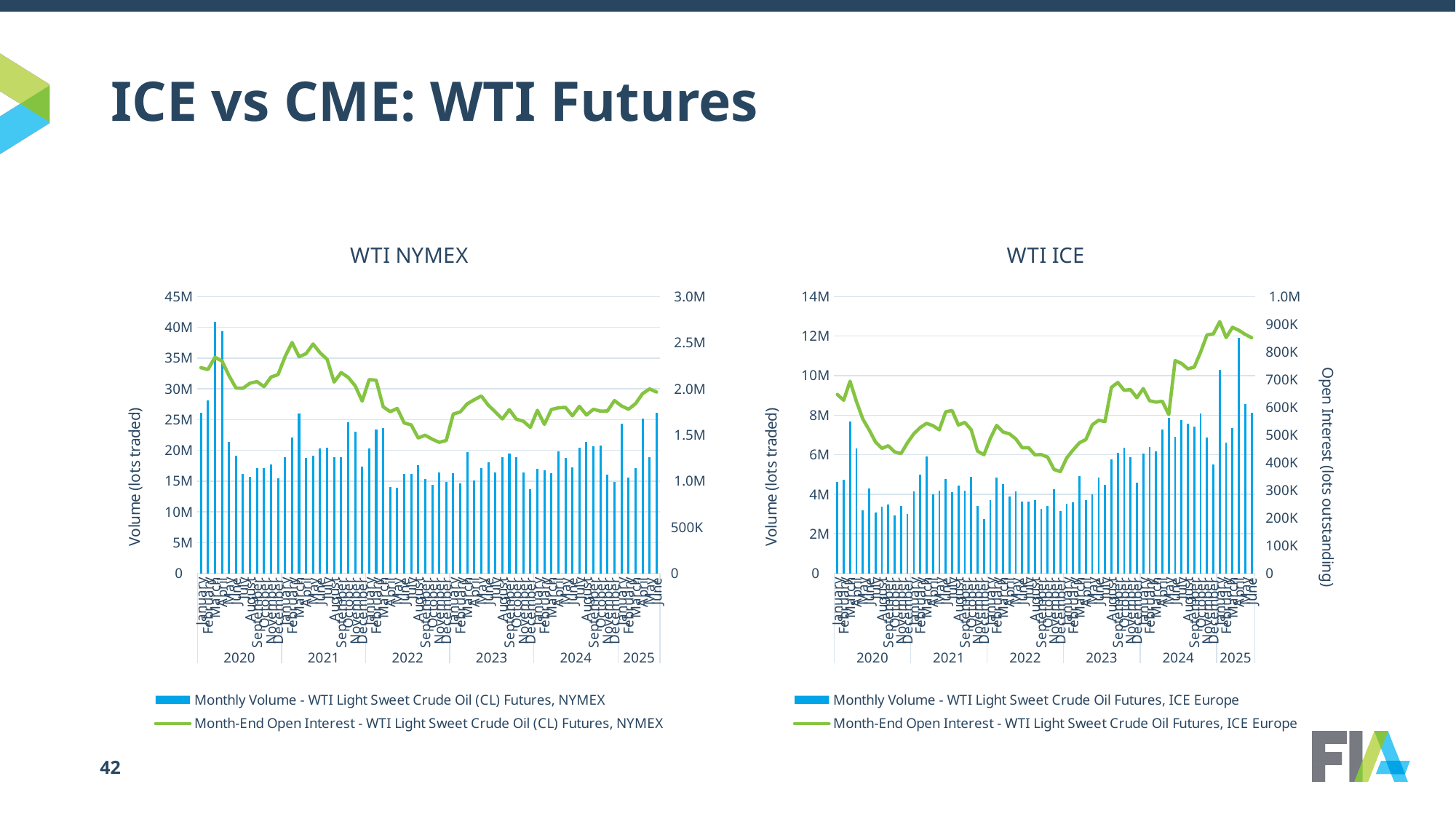
In the WTI ICE chart, does the month-end open interest line rise or fall from 2023 to 2025? rise In the WTI NYMEX chart, is the month-end open interest at the end of 2025 greater or less than 2.5M? less How many series does the legend of the WTI ICE chart list? 2 In the WTI NYMEX chart, is the tallest monthly volume bar greater or less than 35M? greater In the WTI NYMEX chart, does the month-end open interest line rise or fall from 2021 to 2022? fall In the WTI ICE chart, is the tallest monthly volume bar greater or less than 10M? greater In the WTI ICE chart, which series is drawn as blue bars? Monthly Volume - WTI Light Sweet Crude Oil Futures, ICE Europe In the WTI NYMEX chart, which series is drawn as a green line? Month-End Open Interest - WTI Light Sweet Crude Oil (CL) Futures, NYMEX How many year labels are shown along the x axis of the WTI ICE chart? 6 What kind of chart is the WTI NYMEX chart? A combined bar and line chart How many series does the legend of the WTI NYMEX chart list? 2